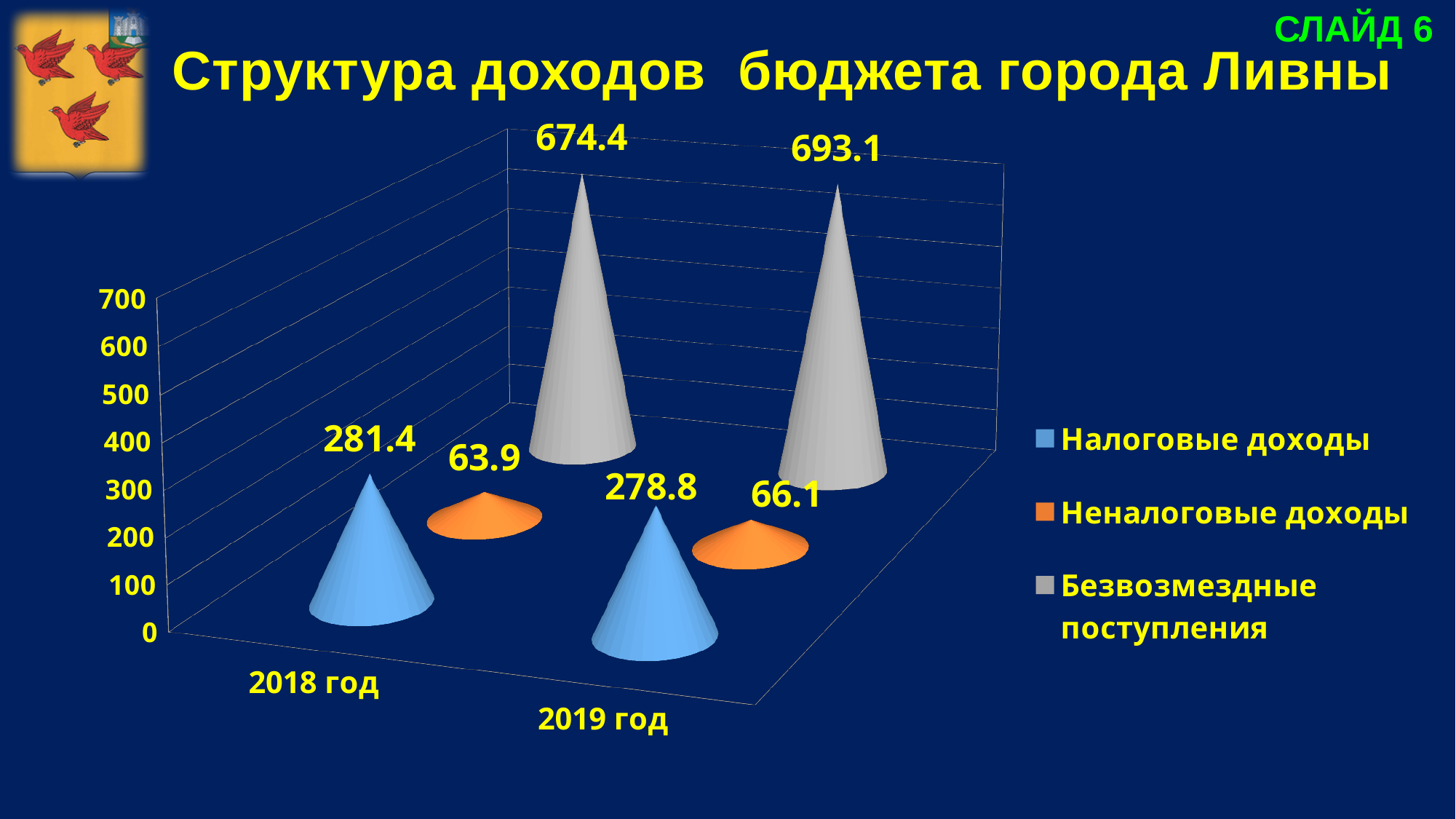
What is the value of Безвозмездные поступления for 2018 год? 674.4 What is the value of Неналоговые доходы for 2019 год? 66.1 Which series has the highest value in 2019 год? Безвозмездные поступления What is the value of Безвозмездные поступления for 2019 год? 693.1 How many year categories are shown on the x axis? 2 What colour represents Неналоговые доходы in the chart? Orange How many series does the legend list? 3 Which series has the lowest value in 2018 год? Неналоговые доходы What is the difference between Налоговые доходы in 2018 год and in 2019 год? 2.6 What is the difference between Безвозмездные поступления in 2019 год and in 2018 год? 18.7 What is the value of Налоговые доходы for 2018 год? 281.4 Which is larger: Неналоговые доходы in 2018 год or in 2019 год? 2019 год